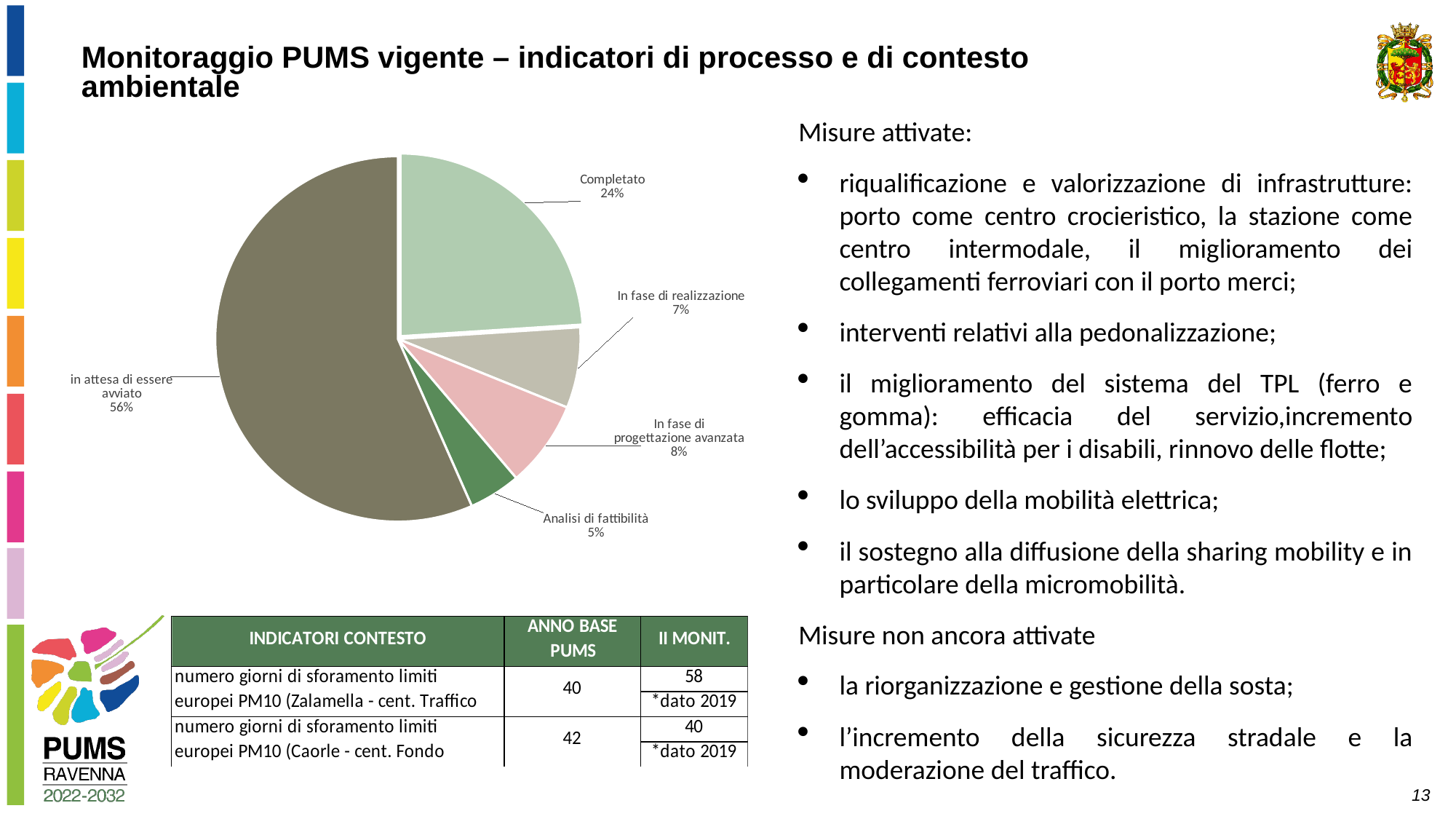
What share of the pie does "in attesa di essere avviato" represent? 56% What kind of chart is shown on the slide? pie chart What is the combined share of "In fase di realizzazione" and "In fase di progettazione avanzata"? 15% How many slices does the pie chart have? 5 Which is larger, the slice for "Completato" or the slice for "In fase di progettazione avanzata"? Completato What is the value shown for "In fase di realizzazione"? 7% What is the value shown for "In fase di progettazione avanzata"? 8% Which category has the smallest slice of the pie? Analisi di fattibilità What is the value shown for "Analisi di fattibilità"? 5% Which category has the largest slice of the pie? in attesa di essere avviato What share of the pie does "Completato" represent? 24% What is the difference in percentage points between "in attesa di essere avviato" and "Completato"? 32